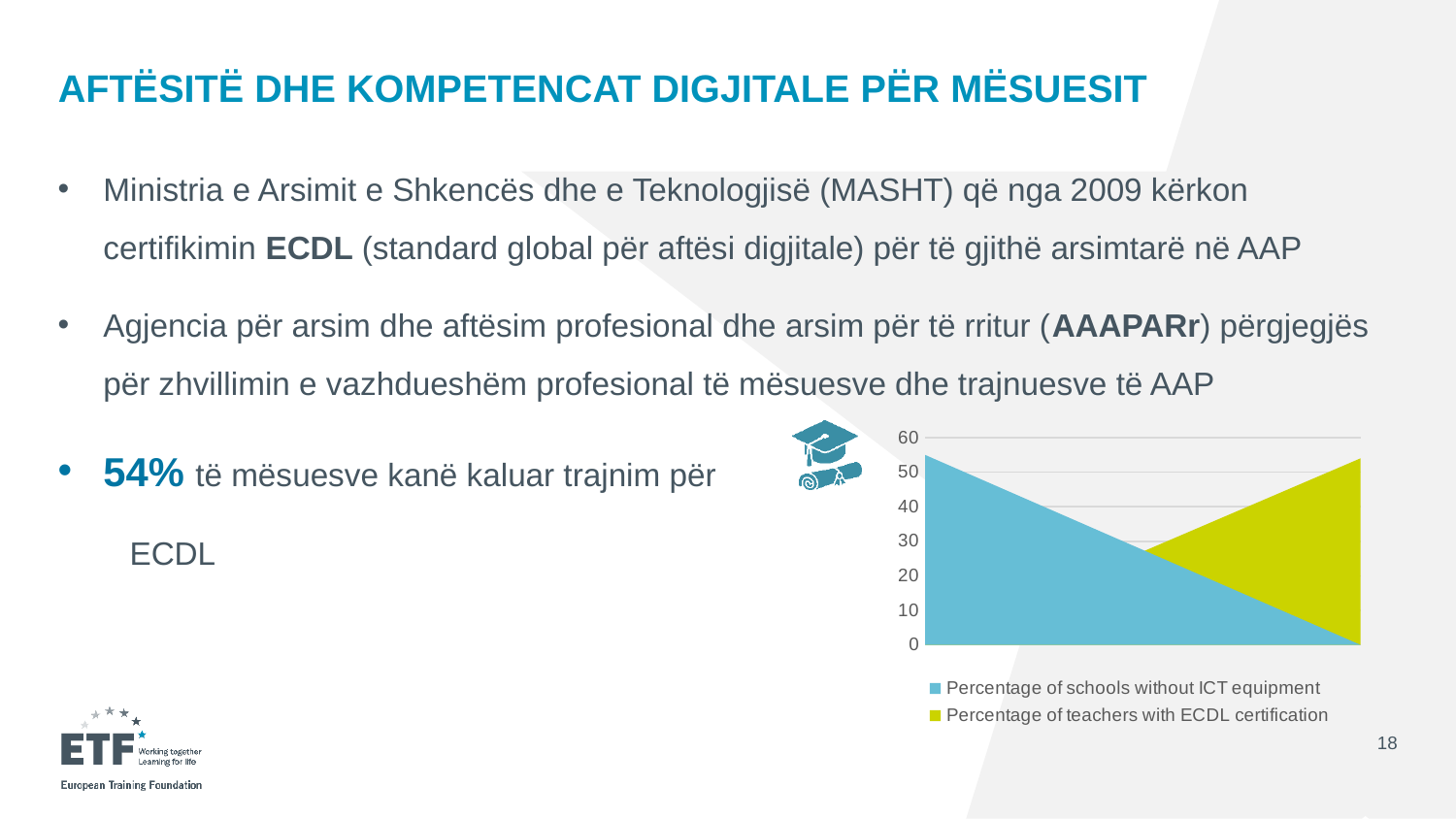
Which series in the chart is shown in yellow-green? Percentage of teachers with ECDL certification At the left end of the chart, is the value for 'Percentage of teachers with ECDL certification' greater or less than 10? less At the right end of the chart, which series has the larger value: 'Percentage of schools without ICT equipment' or 'Percentage of teachers with ECDL certification'? Percentage of teachers with ECDL certification What kind of chart is shown on the slide? Area chart At the right end of the chart, is the value for 'Percentage of teachers with ECDL certification' greater or less than 40? greater Does the 'Percentage of teachers with ECDL certification' series rise or fall from left to right? Rise How many series does the chart legend list? 2 Which series in the chart is shown in blue? Percentage of schools without ICT equipment At the left end of the chart, which series has the larger value: 'Percentage of schools without ICT equipment' or 'Percentage of teachers with ECDL certification'? Percentage of schools without ICT equipment What is the highest value shown on the chart's vertical axis? 60 Does the 'Percentage of schools without ICT equipment' series rise or fall from left to right? Fall At the left end of the chart, is the value for 'Percentage of schools without ICT equipment' greater or less than 40? greater